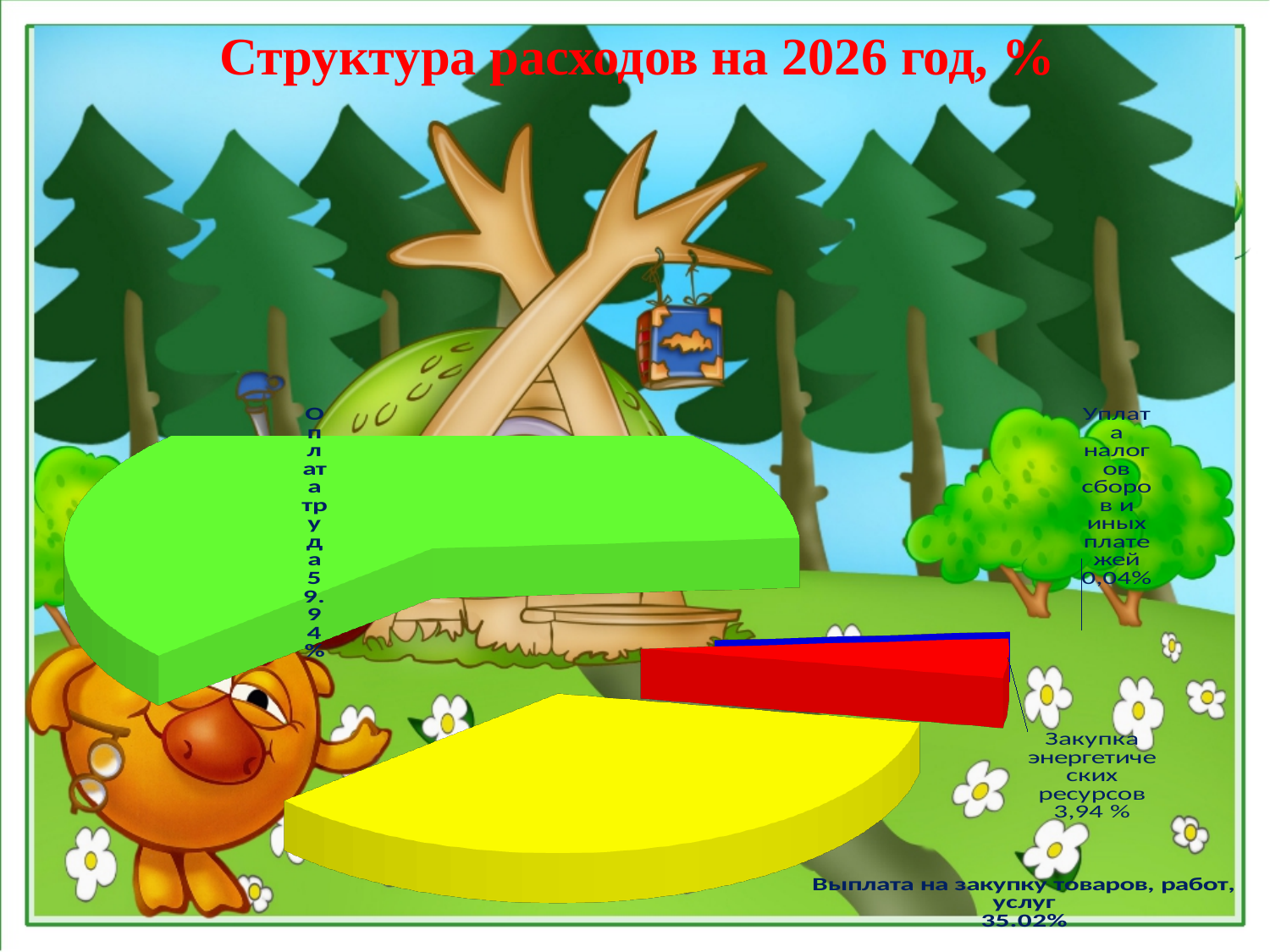
Which category has the smallest share of expenses? Уплата налогов сборов и иных платежей What is the title of the chart? Структура расходов на 2026 год, % What kind of chart is shown on the slide? pie chart What is the value for Уплата налогов сборов и иных платежей? 0,04% What share of expenses is Оплата труда? 59.94% Which is larger: Закупка энергетических ресурсов or Выплата на закупку товаров, работ, услуг? Выплата на закупку товаров, работ, услуг What is the difference between Оплата труда and Выплата на закупку товаров, работ, услуг? 24.92% What is the value for Выплата на закупку товаров, работ, услуг? 35.02% Which category has the largest share of expenses? Оплата труда What is the value for Закупка энергетических ресурсов? 3,94 % How many slices does the pie chart have? 4 What colour is the slice for Оплата труда? green